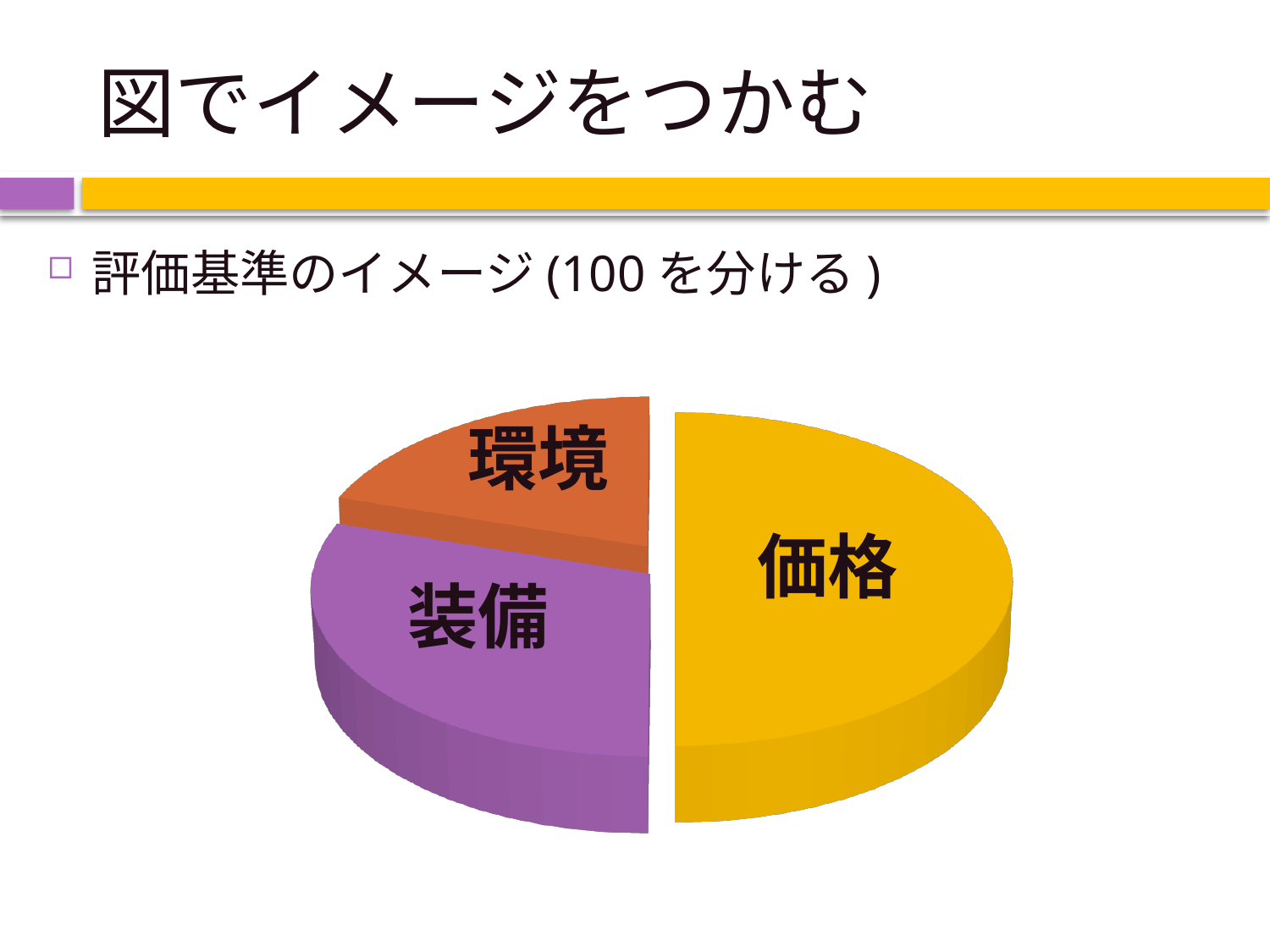
Which category is shown in purple on the pie chart? 装備 Which slice is larger, 装備 or 環境? 装備 What kind of chart is shown on the slide? pie chart Which category has the smallest slice of the pie chart? 環境 Which slice is larger, 価格 or 環境? 価格 Which category has the largest slice of the pie chart? 価格 How many slices does the pie chart have? 3 Which slice is larger, 価格 or 装備? 価格 What colour is the 価格 slice of the pie chart? yellow